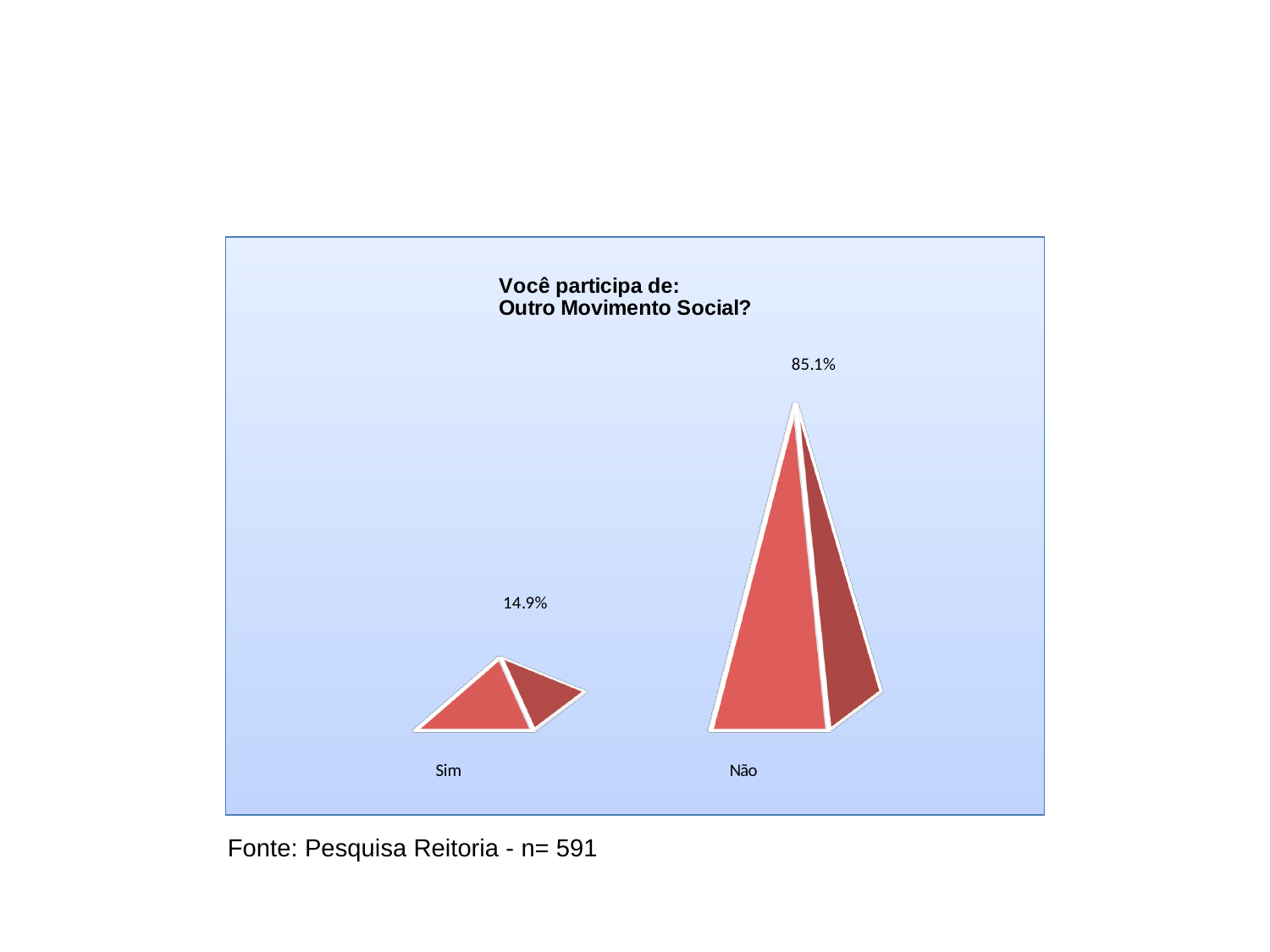
What is the sample size (n) given in the source note below the chart? 591 How many categories are shown in the chart? 2 What is the title of the chart? Você participa de: Outro Movimento Social? Which category has the highest value? Não What is the value for Não? 85.1% Which category has the lowest value? Sim What is the value for Sim? 14.9% What kind of chart is shown on the slide? Bar chart What is the difference between the values for Não and Sim? 70.2% Which is larger, the value for Sim or the value for Não? Não